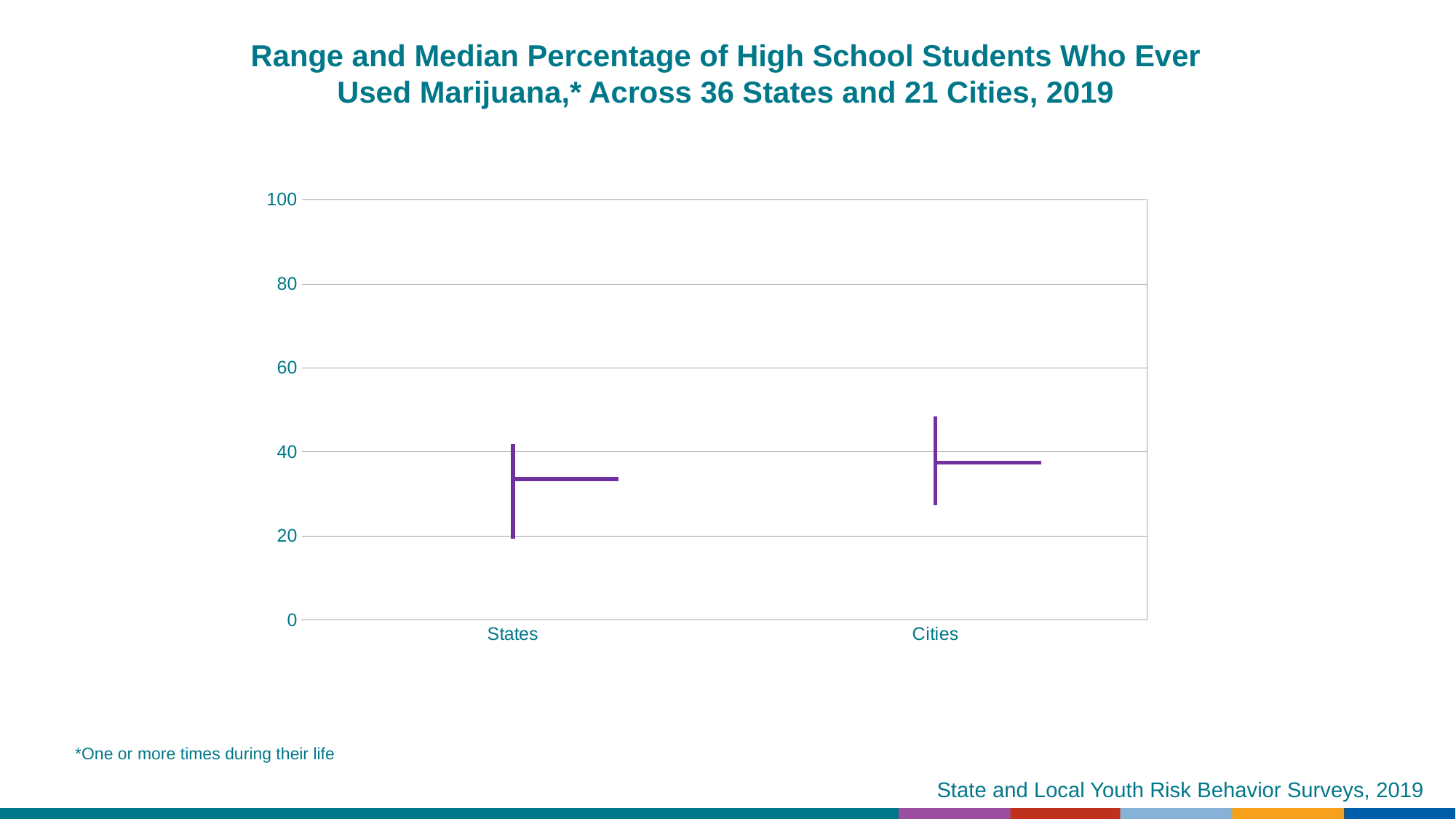
Is the bottom of the range for Cities greater or less than 20? greater Which category has the higher maximum (top of the range), States or Cities? Cities Is the top of the range for Cities greater or less than 60? less How many categories are shown on the x axis of the chart? 2 Is the top of the range for States greater or less than 60? less What is the highest value shown on the y axis of the chart? 100 What are the two categories shown on the x axis? States and Cities Which category has the higher median percentage, States or Cities? Cities Which category has the lower minimum (bottom of the range), States or Cities? States